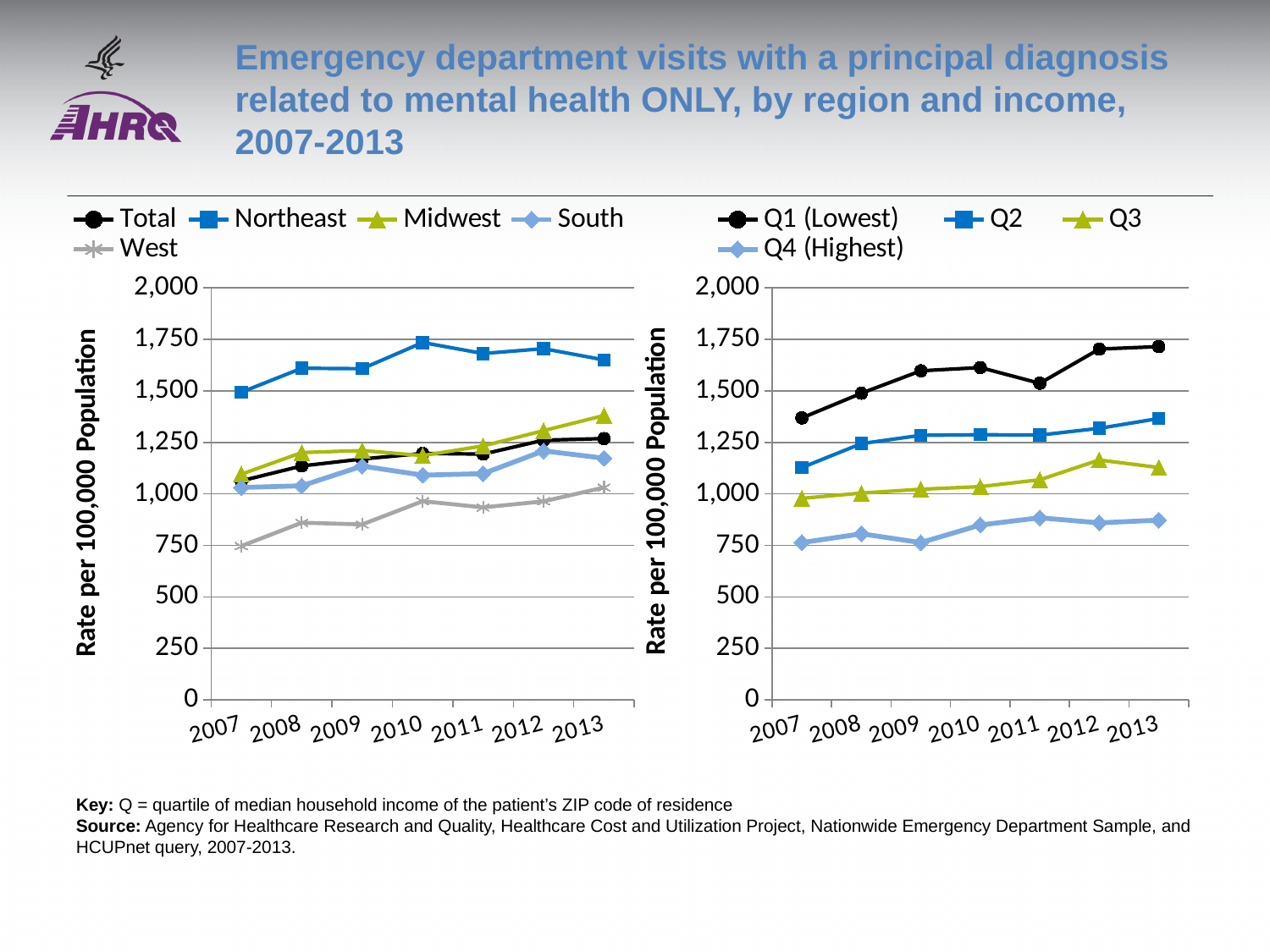
In the right chart (by income quartile), which quartile has the lowest rate in 2011? Q4 (Highest) In the right chart (by income quartile), is the value for Q4 (Highest) in 2011 greater or less than 1,000? less In the left chart (by region), does the West rate rise or fall from 2007 to 2013? rise How many series does the legend of the left chart (by region) list? 5 How many series does the legend of the right chart (by income quartile) list? 4 In the left chart (by region), which region has the lowest rate in 2007? West How many years are plotted along the x axis of the right chart (by income quartile)? 7 In the right chart (by income quartile), which quartile has the highest rate in 2013? Q1 (Lowest) In the left chart (by region), is the value for Northeast in 2010 greater or less than 1,500? greater What kind of chart is the left chart (by region)? Line chart What is the y-axis label of the right chart (by income quartile)? Rate per 100,000 Population In the left chart (by region), which region has the highest rate in 2013? Northeast